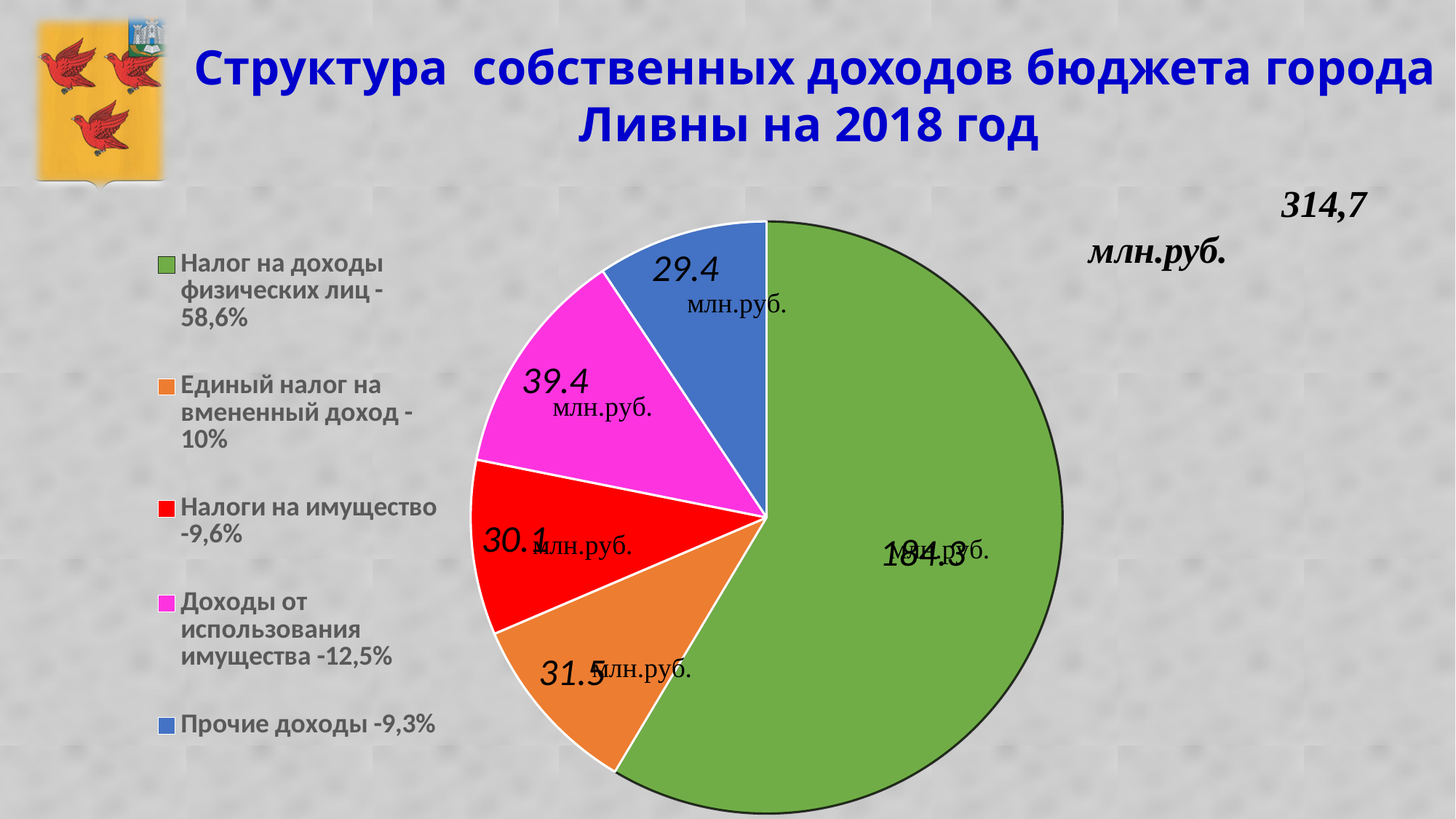
What value is labelled on the slice for Налоги на имущество? 30.1 What value is labelled on the slice for Единый налог на вмененный доход? 31.5 According to the legend, what share of the pie does Налог на доходы физических лиц represent? 58,6% What value is labelled on the slice for Доходы от использования имущества? 39.4 Which is larger: the value for Единый налог на вмененный доход or the value for Налоги на имущество? Единый налог на вмененный доход Which category has the largest slice of the pie? Налог на доходы физических лиц How many slices does the pie chart have? 5 Which category has the smallest slice of the pie? Прочие доходы What kind of chart is shown on the slide? pie chart What value is labelled on the slice for Прочие доходы? 29.4 What total amount is shown in the top right corner of the slide next to the chart? 314,7 млн.руб. What is the difference between the values for Доходы от использования имущества and Прочие доходы? 10